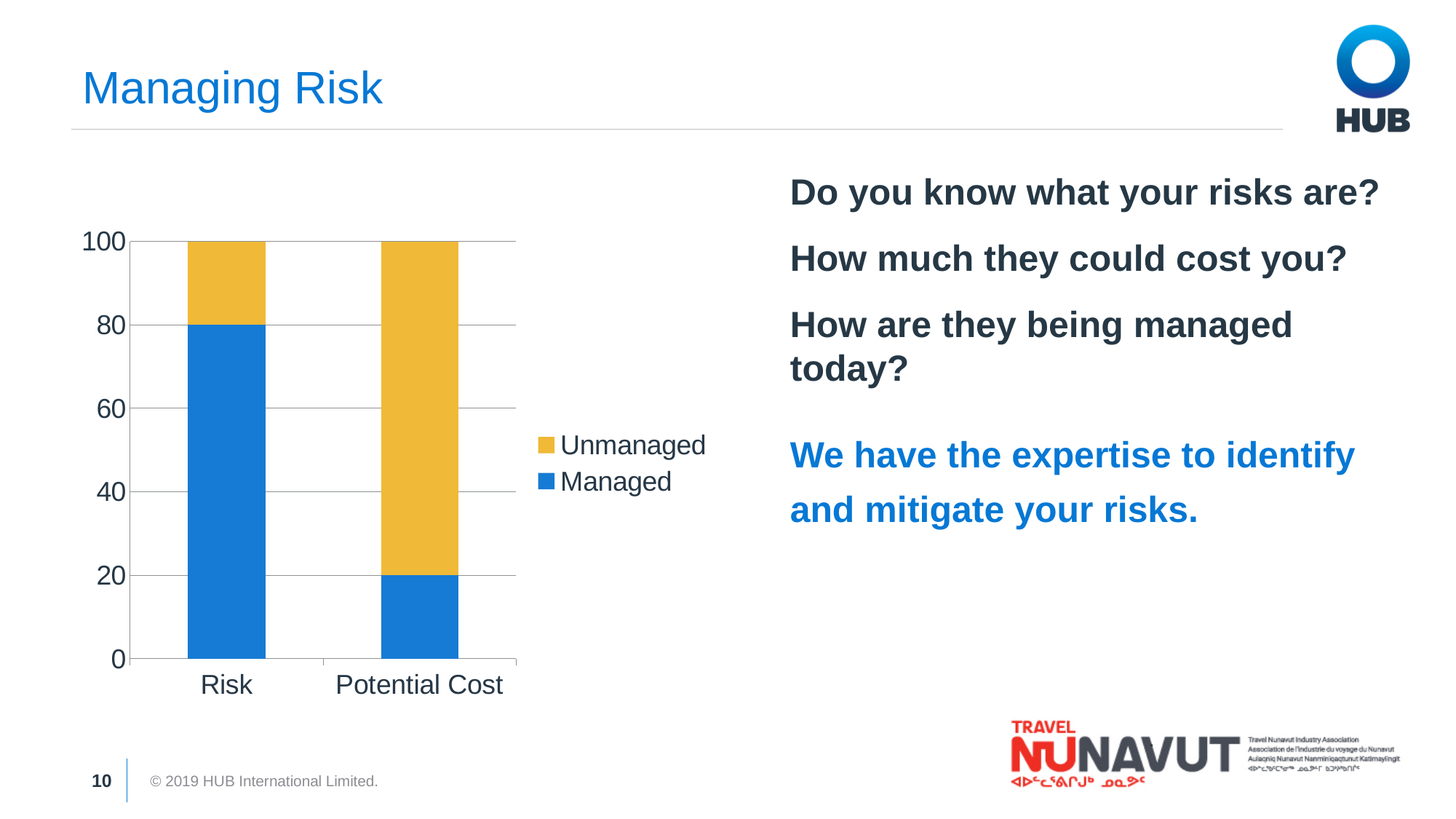
What is the total height of the stacked bar for Potential Cost? 100 What colour represents the Managed series in the chart? Blue What is the total height of the stacked bar for Risk? 100 How many series does the chart legend list? 2 Which category has the larger Managed value, Risk or Potential Cost? Risk What is the Managed value for Risk? 80 What are the two series listed in the chart legend? Unmanaged and Managed How many categories are shown on the x axis of the chart? 2 Which category has the larger Unmanaged segment, Risk or Potential Cost? Potential Cost Is the Unmanaged segment for Potential Cost greater or less than 60? greater What is the Managed value for Potential Cost? 20 What kind of chart is shown on the slide? Stacked bar chart